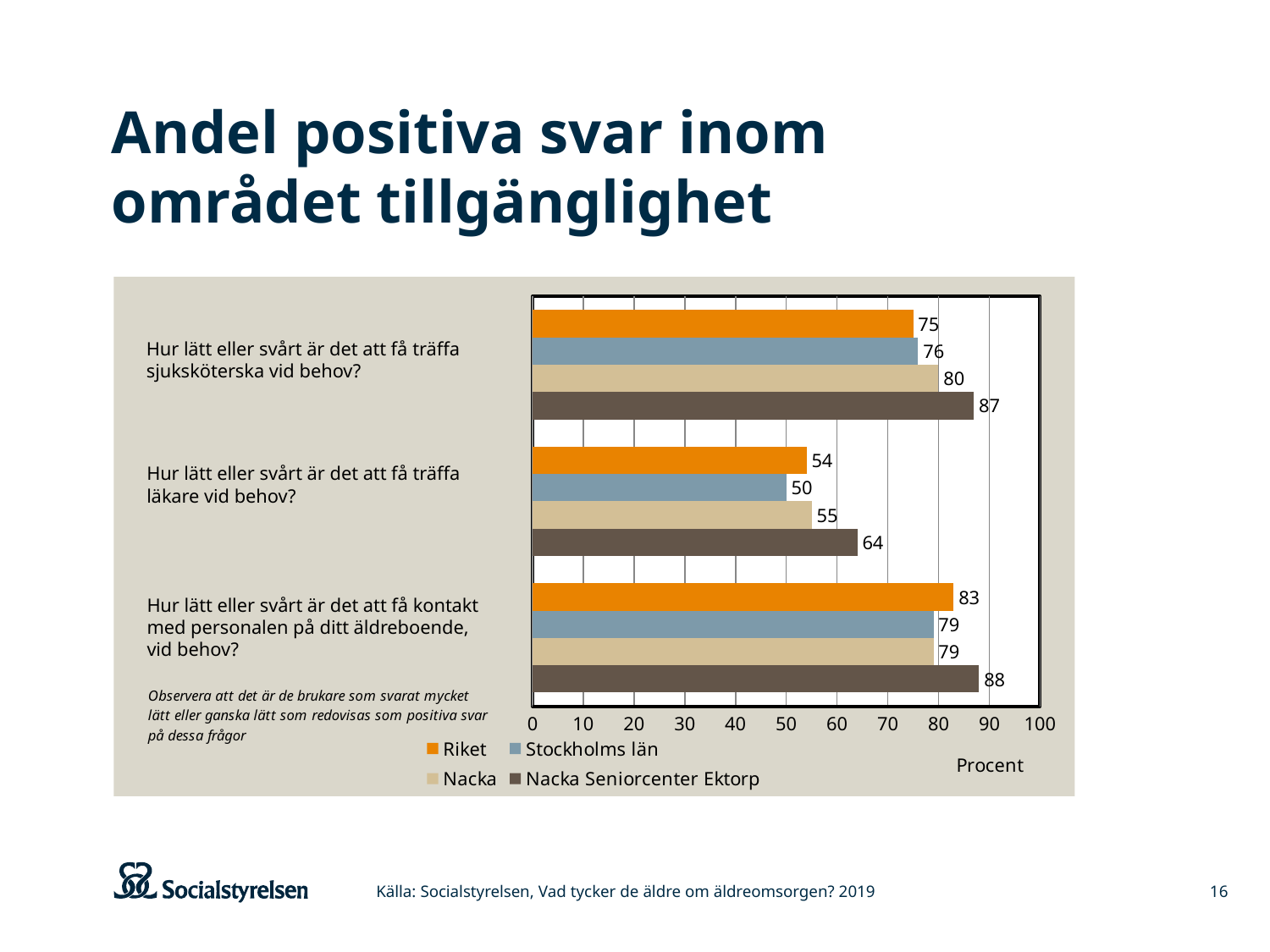
For 'Hur lätt eller svårt är det att få kontakt med personalen på ditt äldreboende, vid behov?', which is larger: Riket or Nacka? Riket What is the value for Stockholms län for 'Hur lätt eller svårt är det att få träffa läkare vid behov?' 50 What is the value for Nacka Seniorcenter Ektorp for 'Hur lätt eller svårt är det att få träffa sjuksköterska vid behov?' 87 Is the value for Nacka for 'Hur lätt eller svårt är det att få träffa läkare vid behov?' greater or less than 60? less How many series does the legend list? 4 What kind of chart is shown on the slide? Bar chart Which series has the highest value for 'Hur lätt eller svårt är det att få träffa läkare vid behov?' Nacka Seniorcenter Ektorp What is the label on the horizontal axis of the chart? Procent How many question categories are plotted on the chart? 3 What is the value for Riket for 'Hur lätt eller svårt är det att få kontakt med personalen på ditt äldreboende, vid behov?' 83 What is the difference between Nacka Seniorcenter Ektorp and Riket for 'Hur lätt eller svårt är det att få träffa läkare vid behov?' 10 Which series has the lowest value for 'Hur lätt eller svårt är det att få träffa sjuksköterska vid behov?' Riket